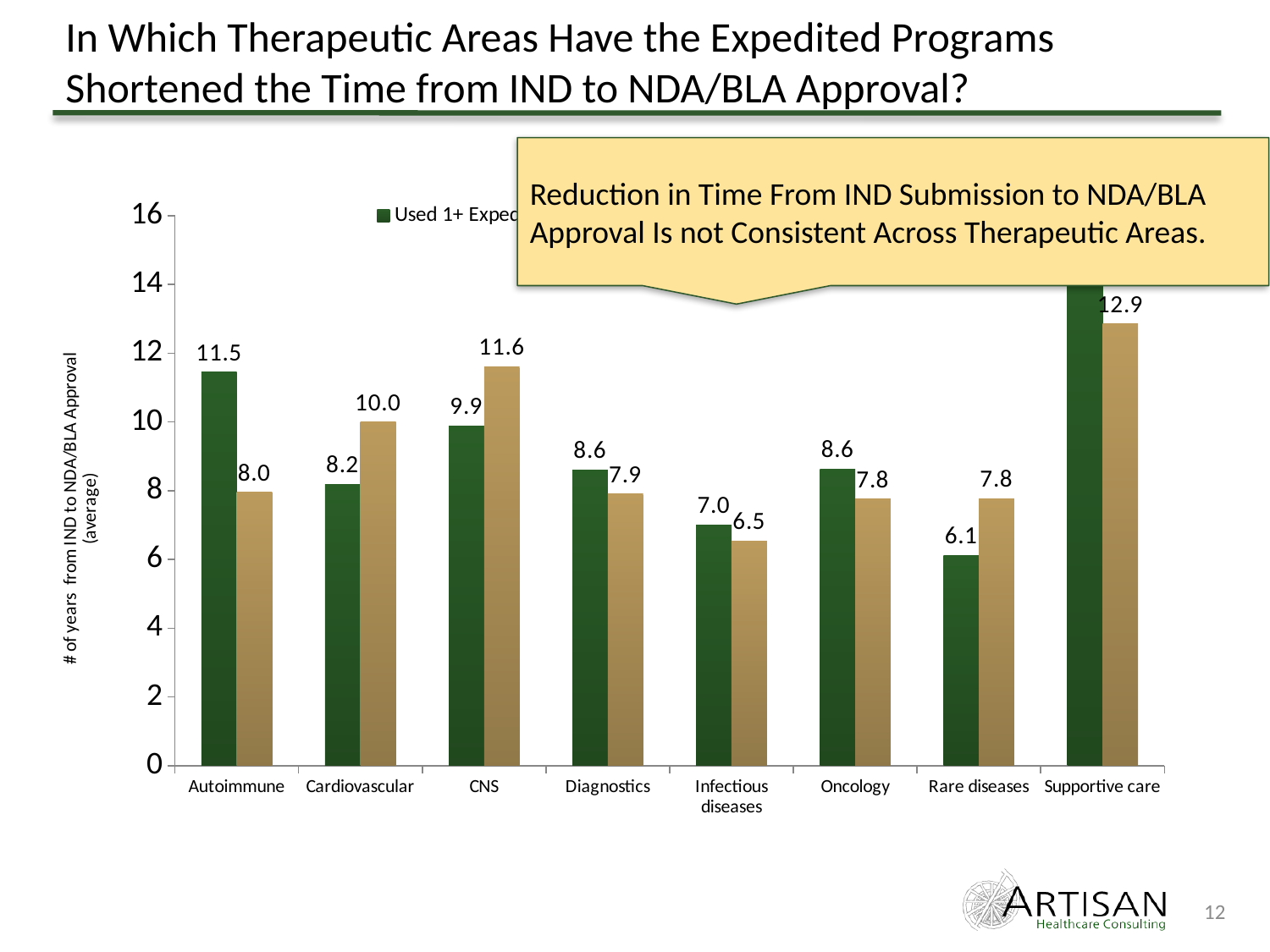
Which therapeutic area has the lowest tan bar? Infectious diseases Is the value of the dark green bar for Supportive care greater or less than 12? greater What is the value of the dark green bar for Autoimmune? 11.5 What is the value of the tan bar for CNS? 11.6 What is the value of the tan bar for Supportive care? 12.9 What is the label on the y axis of the chart? # of years from IND to NDA/BLA Approval (average) How many therapeutic areas are shown on the x axis of the chart? 8 For Cardiovascular, which bar is larger, the dark green bar or the tan bar? The tan bar What kind of chart is shown on the slide? Bar chart Which therapeutic area has the lowest dark green bar? Rare diseases What is the value of the tan bar for Rare diseases? 7.8 For Autoimmune, what is the difference between the dark green bar and the tan bar? 3.5